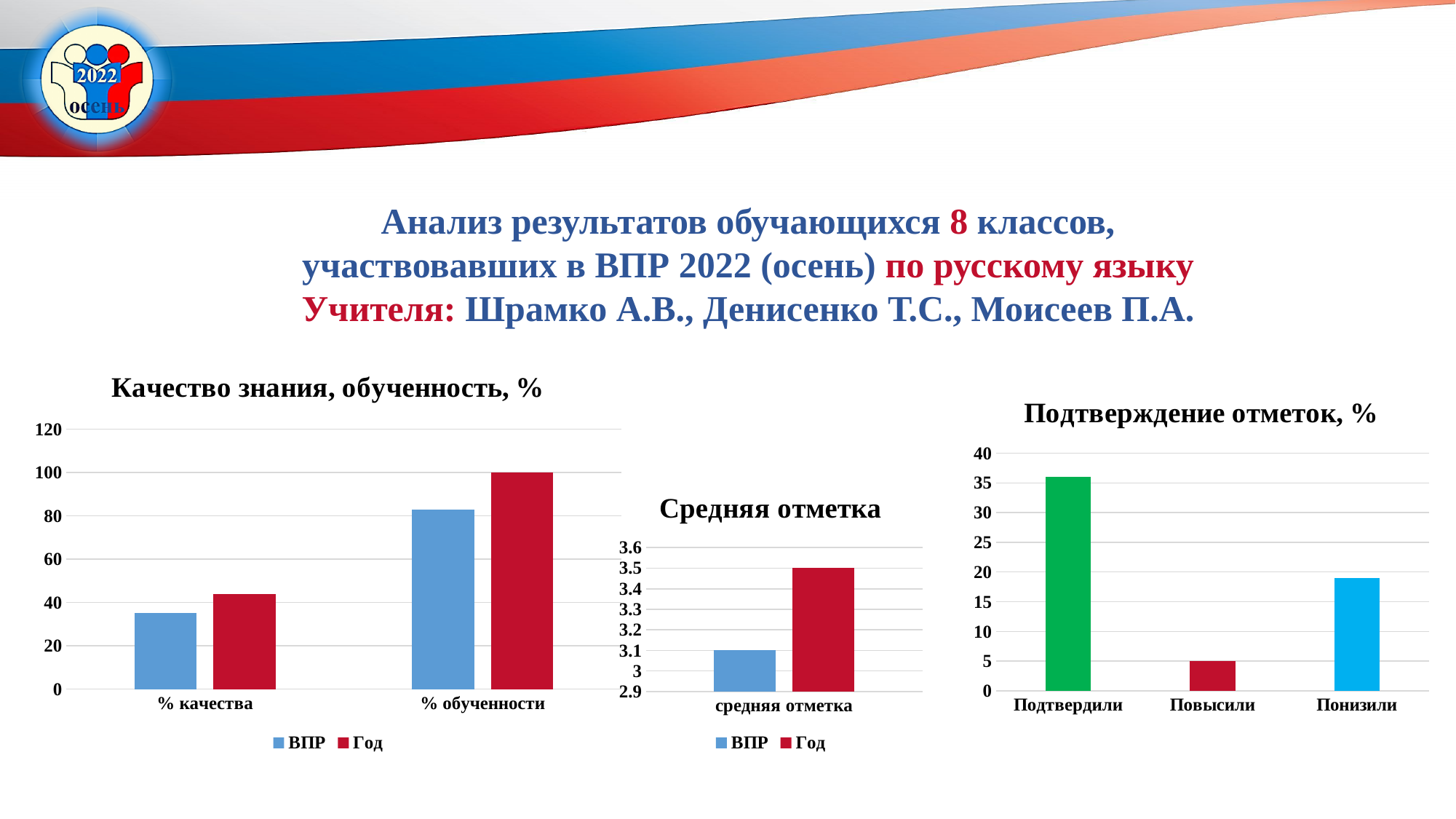
How many series does the legend of the chart titled 'Качество знания, обученность, %' list? 2 On the chart titled 'Средняя отметка', what is the difference between the Год and ВПР values? 0.4 On the chart titled 'Средняя отметка', what is the value for ВПР? 3.1 On the chart titled 'Качество знания, обученность, %', which is larger for % качества, ВПР or Год? Год On the chart titled 'Качество знания, обученность, %', is the ВПР value for % качества greater or less than 40? less On the chart titled 'Средняя отметка', what is the value for Год? 3.5 On the chart titled 'Подтверждение отметок, %', which category has the lowest value? Повысили On the chart titled 'Подтверждение отметок, %', is the value for Подтвердили greater or less than 30? greater On the chart titled 'Подтверждение отметок, %', which category has the highest value? Подтвердили What type of chart is the chart titled 'Подтверждение отметок, %'? bar chart On the chart titled 'Подтверждение отметок, %', what is the value for Повысили? 5 On the chart titled 'Качество знания, обученность, %', what is the Год value for % обученности? 100